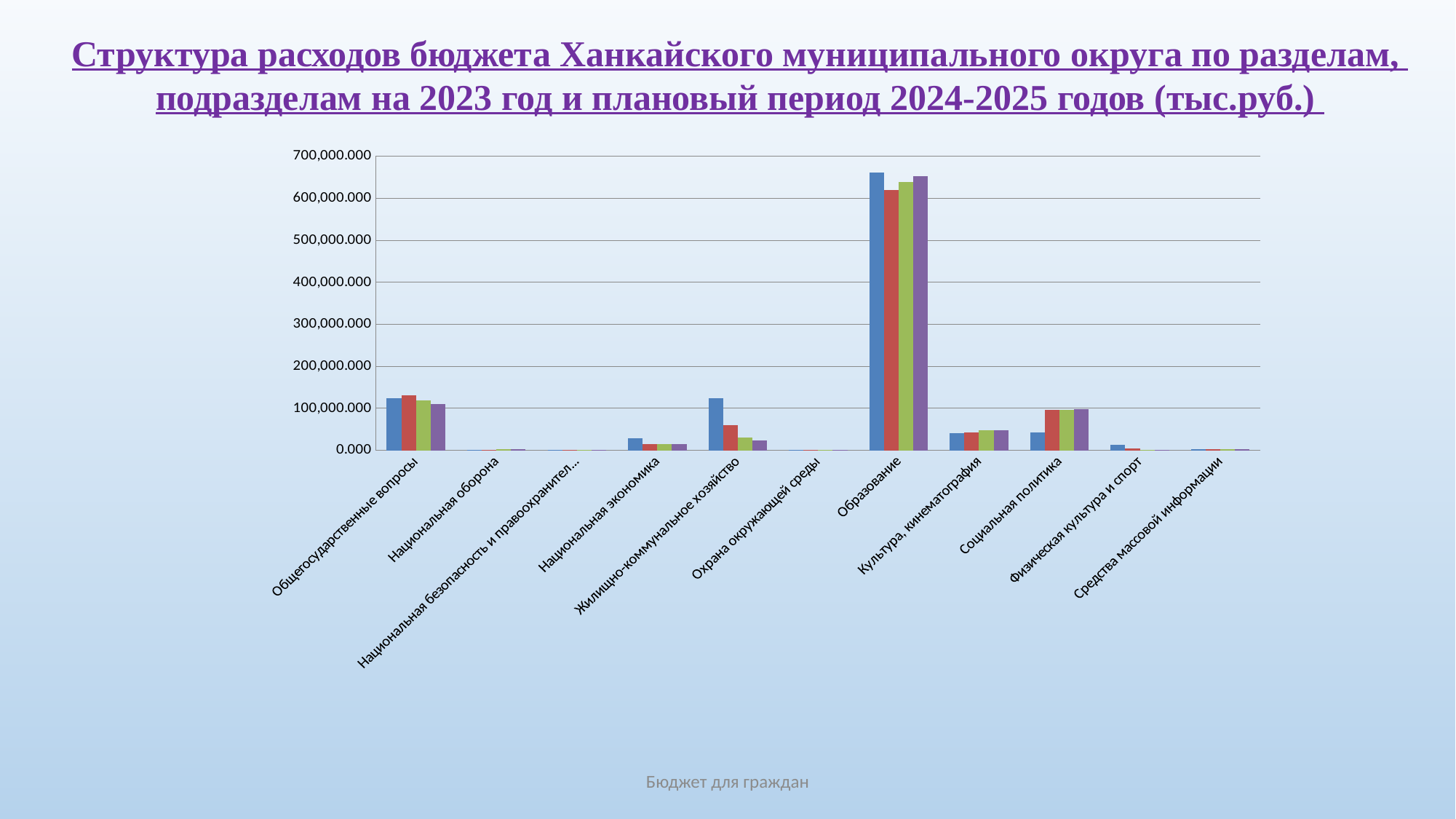
Is the value of the first (blue) bar for Социальная политика greater or less than 100,000.000? less Is the value of the first (blue) bar for Общегосударственные вопросы greater or less than 100,000.000? greater Is the value of the first (blue) bar for Образование greater or less than 600,000.000? greater How many categories are shown along the x axis of the chart? 11 Which has the larger first (blue) bar, Жилищно-коммунальное хозяйство or Национальная экономика? Жилищно-коммунальное хозяйство What is the highest value shown on the vertical axis of the chart? 700,000.000 Which category has the highest values in the chart? Образование How many bars are plotted for each category in the chart? 4 What text appears at the bottom of the slide below the chart? Бюджет для граждан Which category has larger values, Образование or Общегосударственные вопросы? Образование What kind of chart is shown on the slide? bar chart